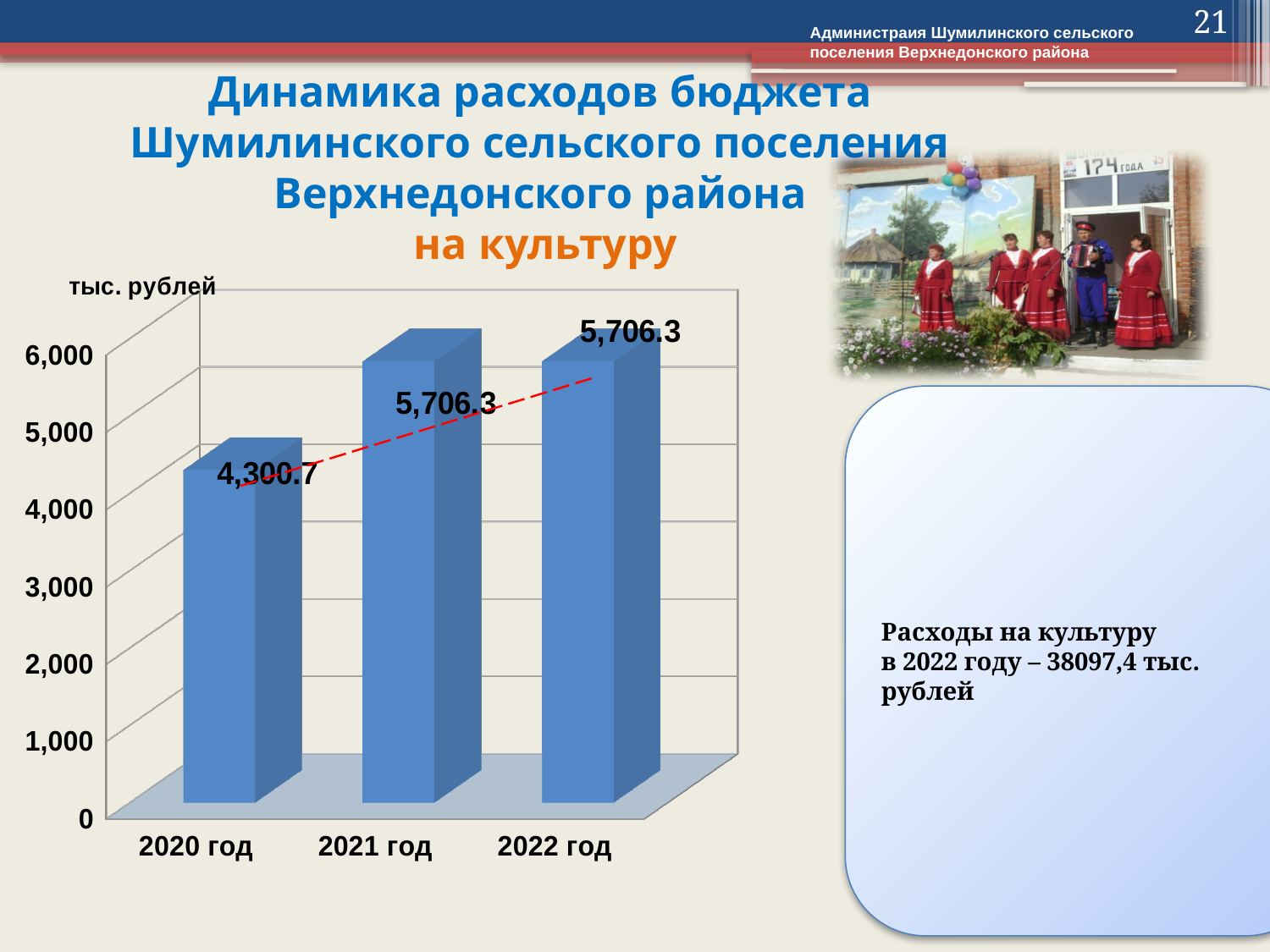
Which is larger, the value for 2020 год or the value for 2021 год? 2021 год Which year has the lowest value? 2020 год Is the value for 2022 год greater or less than 6,000? less Do the values rise or fall from 2020 год to 2021 год? rise What is the value for 2021 год? 5,706.3 What kind of chart is shown on the slide? bar chart What is the difference between the values for 2021 год and 2020 год? 1,405.6 What is the value for 2022 год? 5,706.3 What unit is shown above the vertical axis of the chart? тыс. рублей What is the value for 2020 год? 4,300.7 How many years are shown on the chart? 3 Is the value for 2020 год greater or less than 4,000? greater